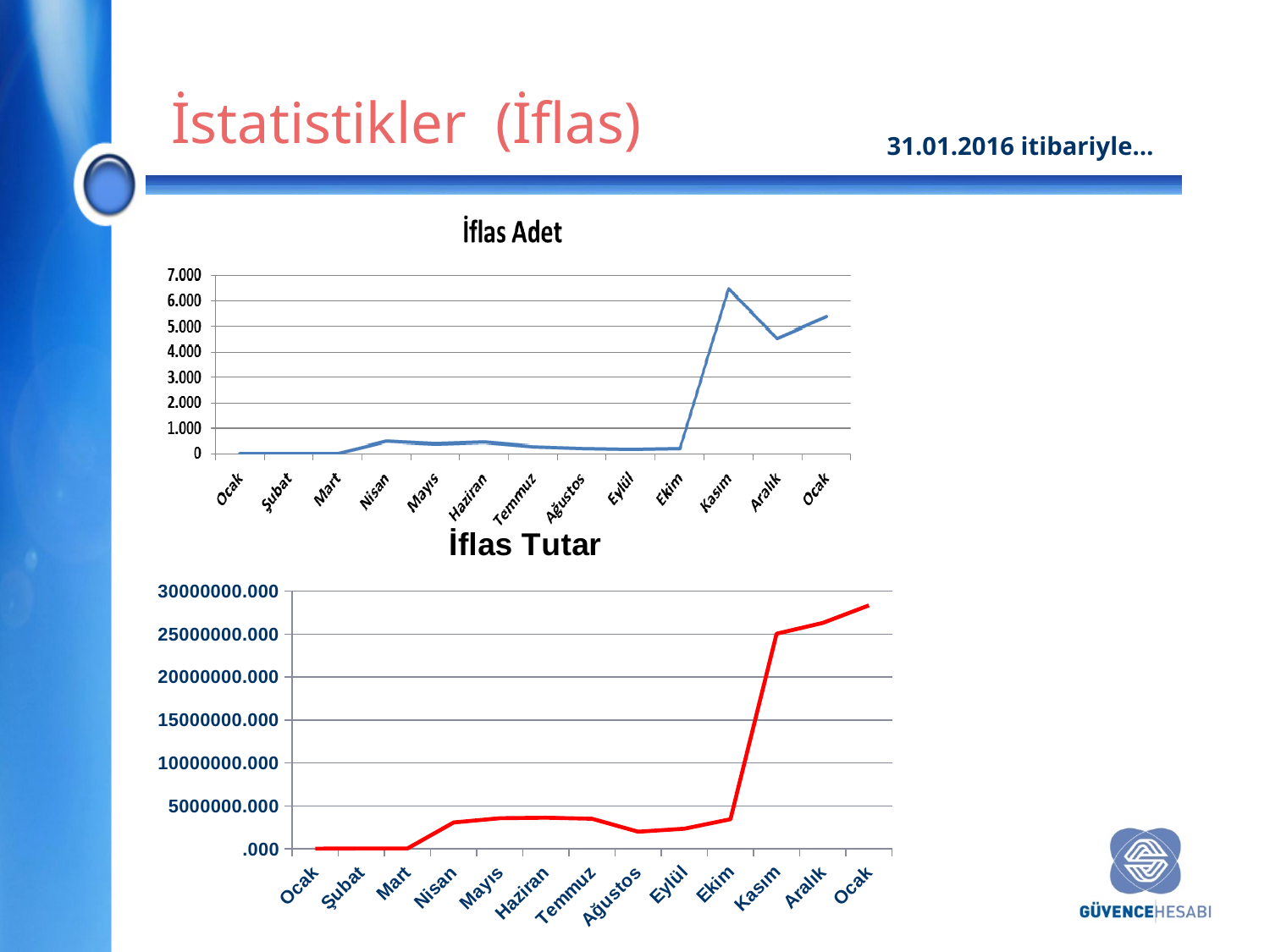
What kind of chart is the "İflas Tutar" chart? line chart In the "İflas Adet" chart, is the value for Kasım greater or less than 6.000? greater In the "İflas Tutar" chart, is the value for Kasım greater or less than 20000000.000? greater In the "İflas Adet" chart, which is larger, the value for Kasım or the value for Aralık? Kasım In the "İflas Tutar" chart, is the value for Ekim greater or less than 5000000.000? less What colour is the line in the "İflas Tutar" chart? red In the "İflas Adet" chart, which month has the highest value? Kasım How many points are plotted along the x axis of the "İflas Adet" chart? 13 In the "İflas Tutar" chart, do the values overall rise or fall from the first Ocak to the last Ocak? rise In the "İflas Tutar" chart, which point has the highest value? Ocak (the last point) What kind of chart is the "İflas Adet" chart? line chart